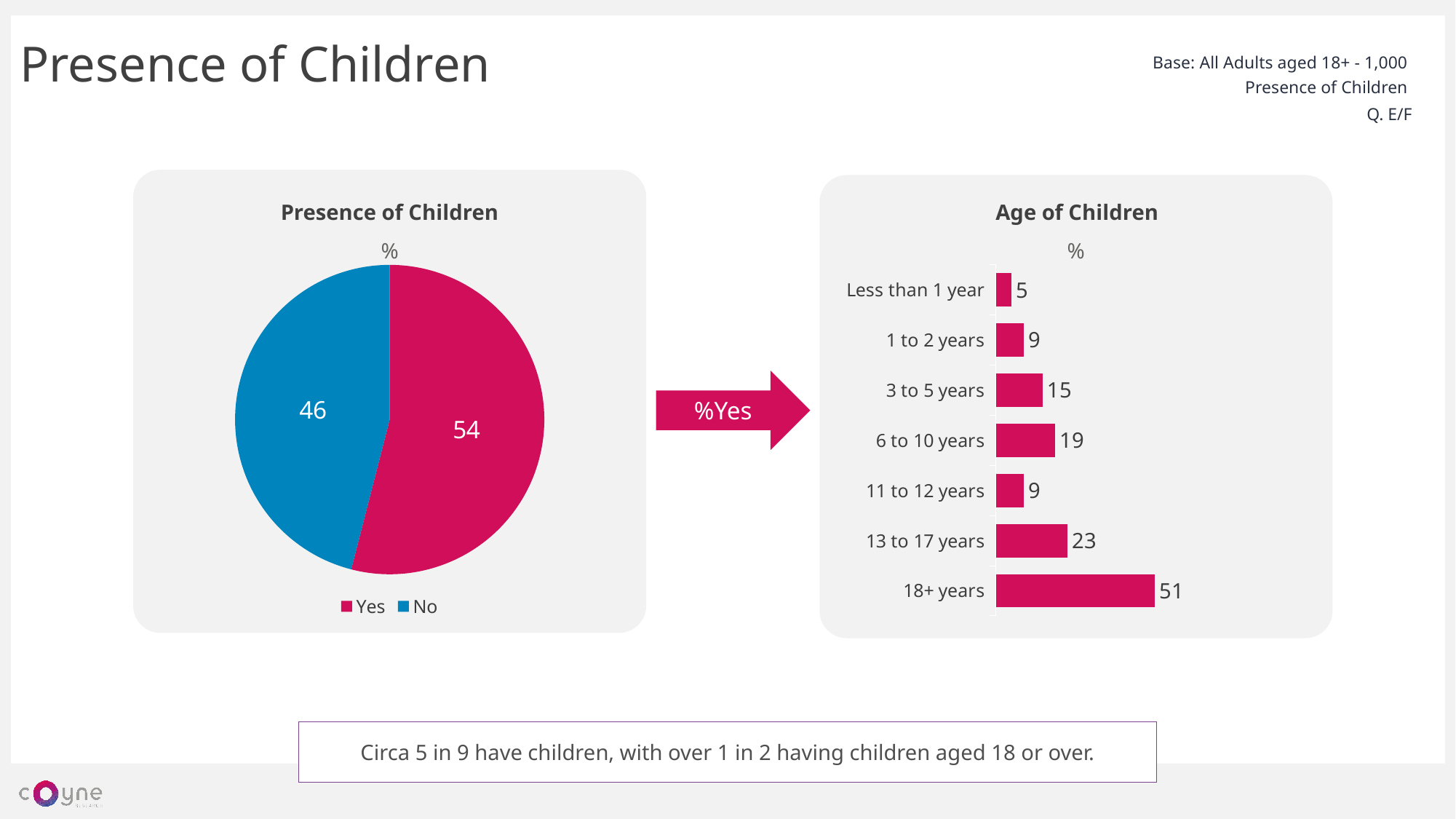
In the 'Presence of Children' pie chart, what is the value for No? 46 In the 'Presence of Children' pie chart, what is the difference between the Yes and No values? 8 What kind of chart is the 'Presence of Children' chart? Pie chart In the 'Age of Children' chart, which category has the lowest value? Less than 1 year In the 'Age of Children' chart, what is the value for 13 to 17 years? 23 In the 'Age of Children' chart, what is the difference between 18+ years and 3 to 5 years? 36 In the 'Presence of Children' pie chart, which slice is larger, Yes or No? Yes In the 'Age of Children' chart, what is the value for 6 to 10 years? 19 In the 'Presence of Children' pie chart, what is the value for Yes? 54 How many categories are shown in the 'Age of Children' chart? 7 How many entries does the legend of the 'Presence of Children' chart list? 2 In the 'Age of Children' chart, which category has the highest value? 18+ years